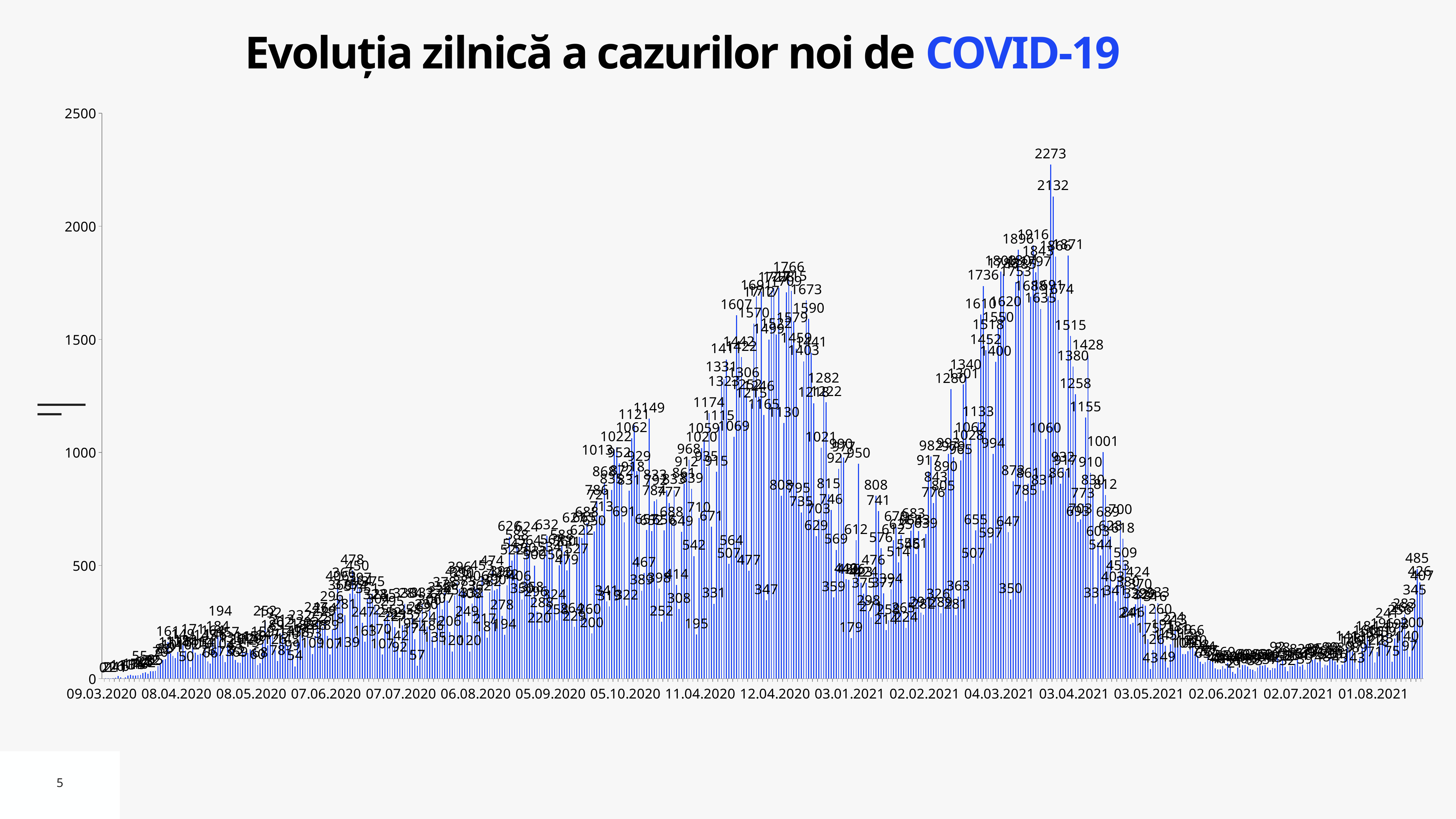
What is the first date label on the horizontal axis? 09.03.2020 What is the title of the chart? Evoluția zilnică a cazurilor noi de COVID-19 What is the highest daily value labelled on the chart? 2273 What is the second-highest daily value labelled on the chart, next to the 2273 peak? 2132 Is the highest bar on the chart greater or less than 2000? greater What is the last date label on the horizontal axis? 01.08.2021 What kind of chart is shown on the slide? bar chart Do the values rise or fall between 03.04.2021 and 02.06.2021? fall Are the bars at the far right end of the chart (around 01.08.2021) greater or less than 1000? less What is the difference between the two highest labelled values, 2273 and 2132? 141 What is the highest value shown on the vertical axis? 2500 Is the tallest bar near 03.04.2021 taller or shorter than the tallest bar near 12.04.2020? taller